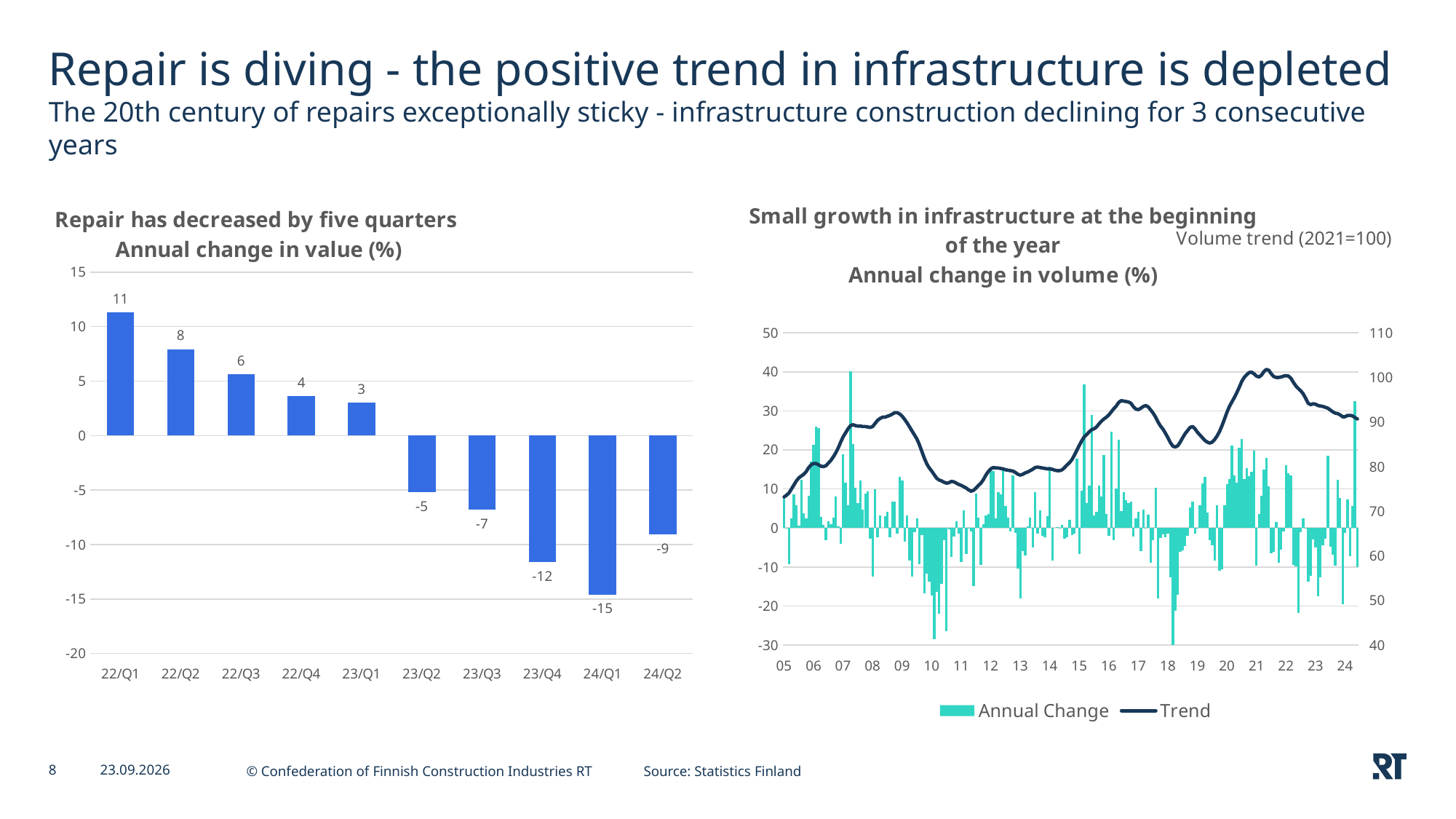
How many series does the legend of the 'Small growth in infrastructure at the beginning of the year' chart list? 2 In the 'Repair has decreased by five quarters' chart, what is the difference between the values for 22/Q1 and 22/Q2? 3 In the 'Repair has decreased by five quarters' chart, which is larger, the value for 23/Q2 or the value for 23/Q3? 23/Q2 What kind of chart is the 'Repair has decreased by five quarters' chart? Bar chart In the 'Repair has decreased by five quarters' chart, which quarter has the highest annual change in value? 22/Q1 What are the two legend entries in the 'Small growth in infrastructure at the beginning of the year' chart? Annual Change and Trend In the 'Repair has decreased by five quarters' chart, which quarter has the lowest annual change in value? 24/Q1 In the 'Repair has decreased by five quarters' chart, what is the value for 23/Q4? -12 In the 'Repair has decreased by five quarters' chart, what is the annual change in value for 24/Q1? -15 How many quarters are shown in the 'Repair has decreased by five quarters' chart? 10 In the 'Repair has decreased by five quarters' chart, do the values rise or fall from 22/Q1 to 23/Q1? Fall In the 'Repair has decreased by five quarters' chart, what is the annual change in value for 22/Q1? 11